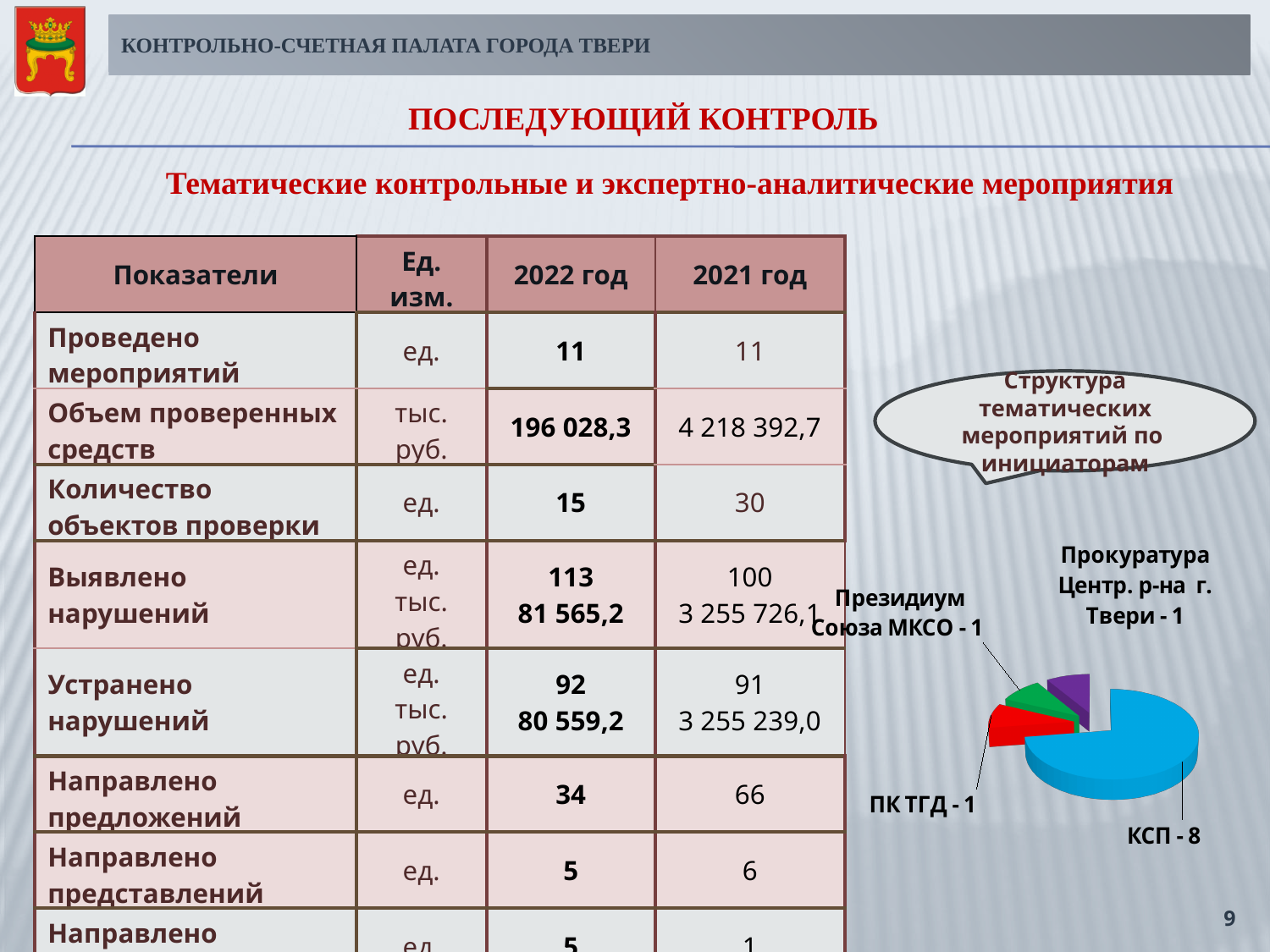
In the pie chart, what is the value for КСП? 8 What kind of chart is shown on the right side of the slide? pie chart In the pie chart, what is the value for Президиум Союза МКСО? 1 What is the total of all slice values in the pie chart? 11 In the pie chart, what is the value for Прокуратура Центр. р-на г. Твери? 1 In the pie chart, what is the difference between the value for КСП and the value for ПК ТГД? 7 In the pie chart, which is larger: the value for КСП or the value for Президиум Союза МКСО? КСП How many slices does the pie chart have? 4 What is the title of the pie chart on the slide? Структура тематических мероприятий по инициаторам In the pie chart, what is the value for ПК ТГД? 1 Which initiator has the largest slice in the pie chart? КСП What colour is the КСП slice in the pie chart? blue